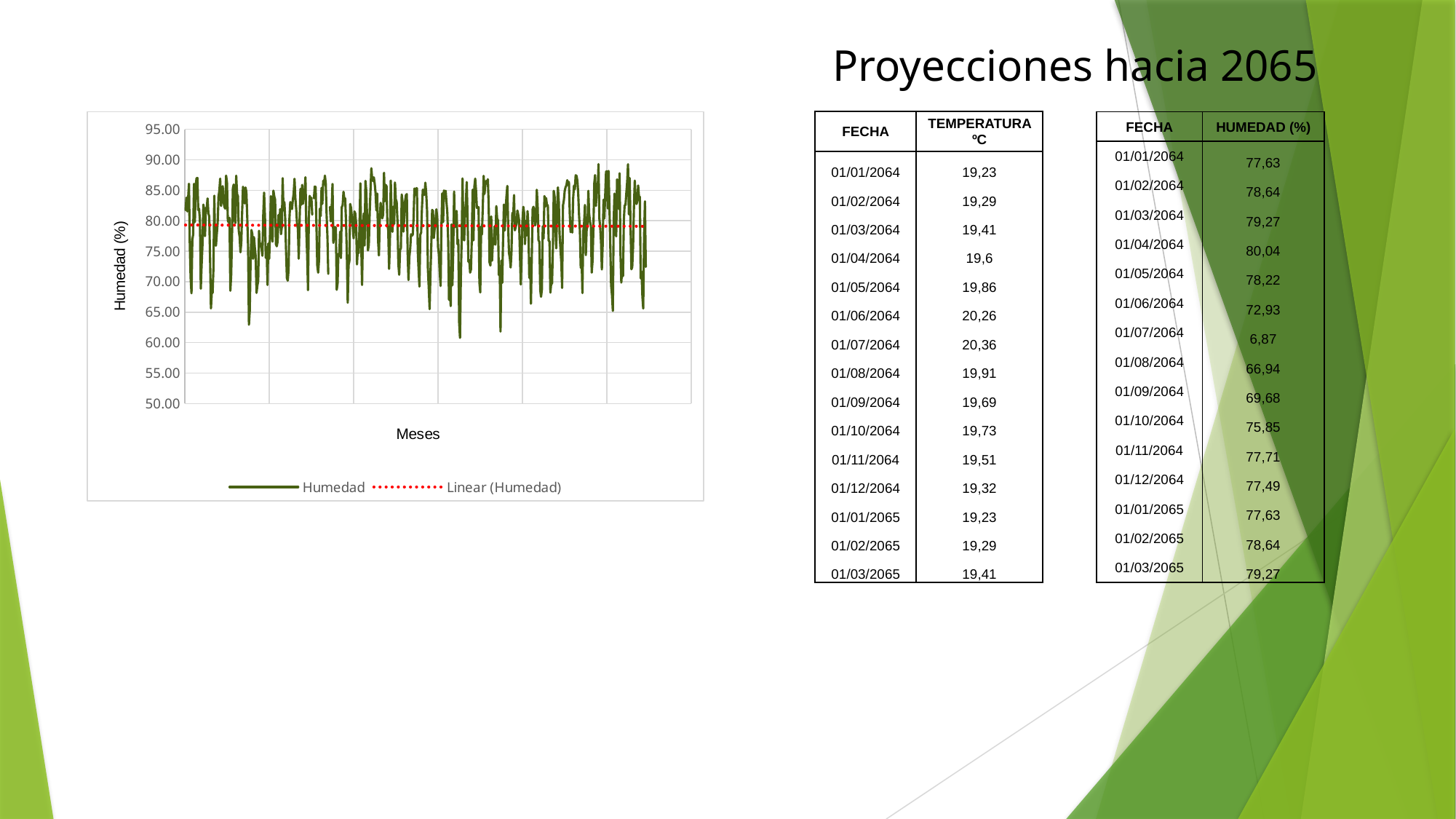
Does the Humedad line ever drop below 55.00 on the vertical axis? No Is the highest peak of the Humedad line greater or less than 85.00? greater What is the label on the chart's vertical axis? Humedad (%) How many series does the chart's legend list? 2 What kind of chart is shown on the slide? line chart What are the two entries in the chart's legend? Humedad and Linear (Humedad) Is the dotted linear trendline (Linear (Humedad)) greater or less than 85.00 on the vertical axis? less